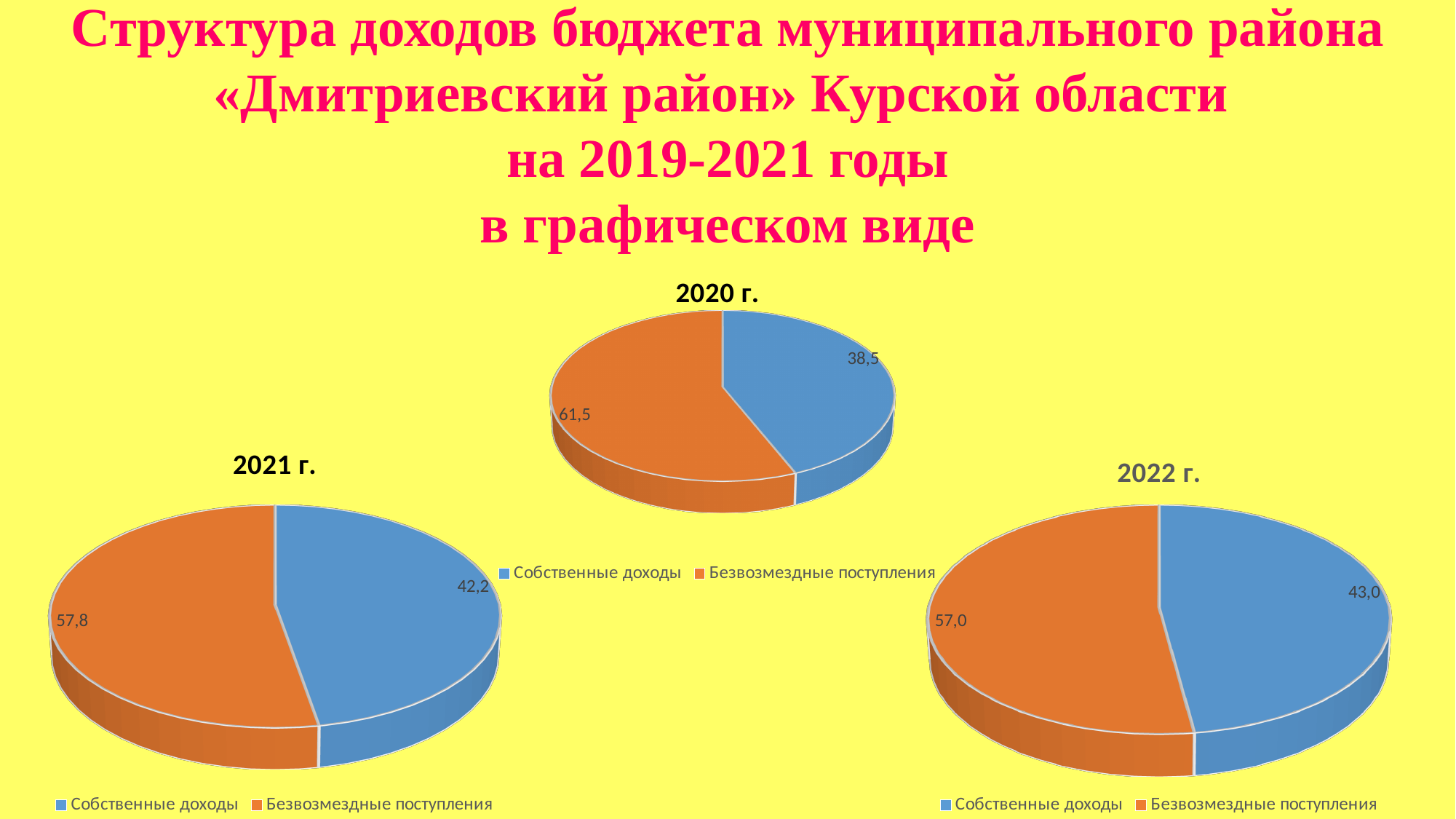
Which is larger in the chart titled "2021 г.": Собственные доходы or Безвозмездные поступления? Безвозмездные поступления In the chart titled "2020 г.", what is the value for Собственные доходы? 38,5 How many entries does the legend of the chart titled "2021 г." list? 2 What kind of chart is the one titled "2020 г."? Pie chart In the chart titled "2020 г.", what is the difference between Безвозмездные поступления and Собственные доходы? 23,0 In the chart titled "2022 г.", what is the difference between Безвозмездные поступления and Собственные доходы? 14,0 In the chart titled "2022 г.", what is the value for Собственные доходы? 43,0 In the chart titled "2021 г.", what is the value for Безвозмездные поступления? 57,8 In the chart titled "2020 г.", what is the value for Безвозмездные поступления? 61,5 In the chart titled "2021 г.", which category has the largest slice? Безвозмездные поступления In the chart titled "2022 г.", which category has the smallest slice? Собственные доходы How many slices does the chart titled "2022 г." have? 2